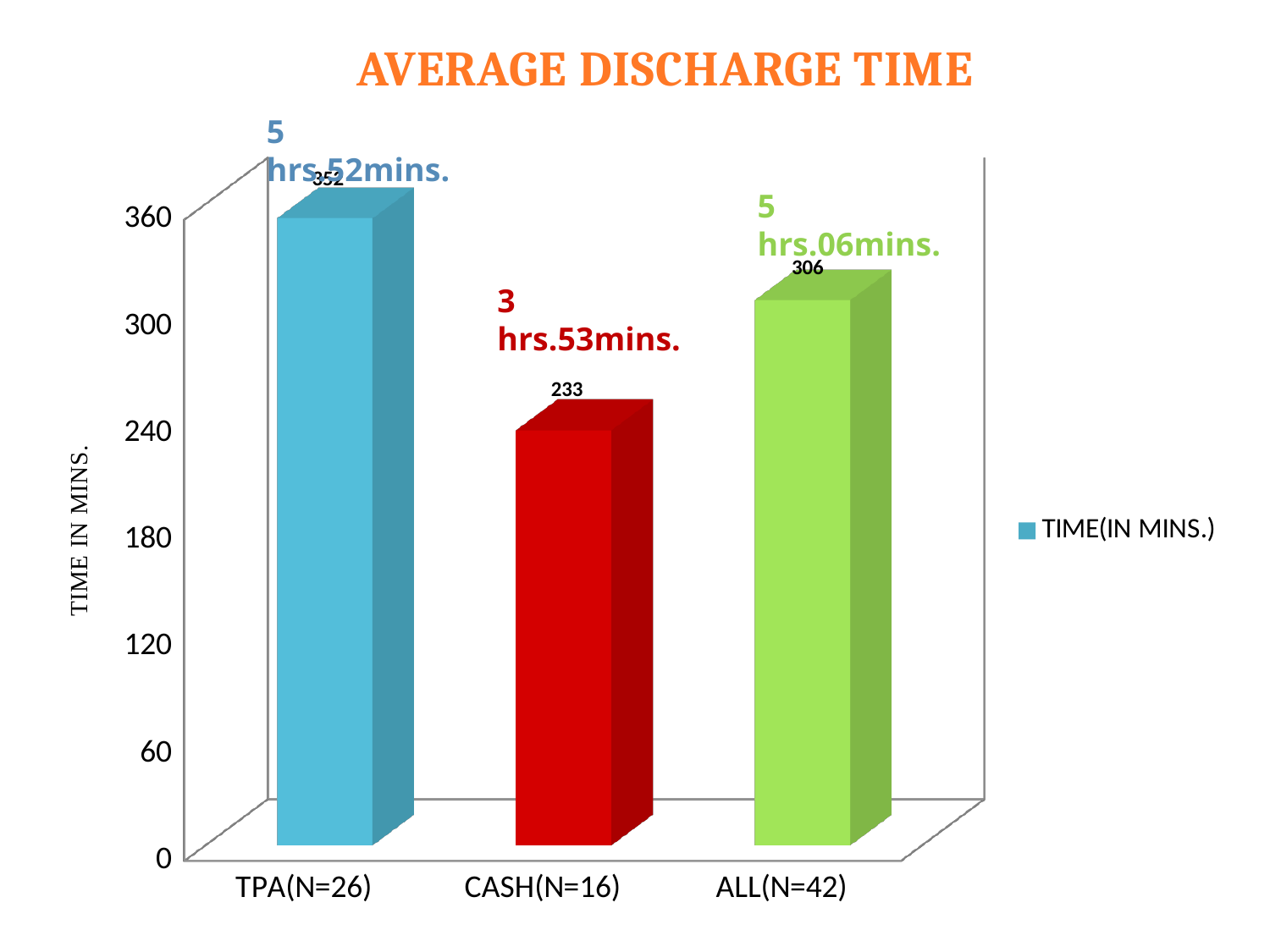
Which has a larger average discharge time, TPA(N=26) or ALL(N=42)? TPA(N=26) Which category has the highest average discharge time? TPA(N=26) What is the difference in minutes between the TPA(N=26) and CASH(N=16) average discharge times? 119 How many series does the legend list? 1 What is the difference in minutes between the ALL(N=42) and CASH(N=16) average discharge times? 73 What is the average discharge time in minutes for TPA(N=26)? 352 What is the average discharge time in minutes for ALL(N=42)? 306 What kind of chart is shown on the slide? Bar chart What is the average discharge time in minutes for CASH(N=16)? 233 Which category has the lowest average discharge time? CASH(N=16) What is the title of the chart? AVERAGE DISCHARGE TIME How many categories are shown on the x axis? 3